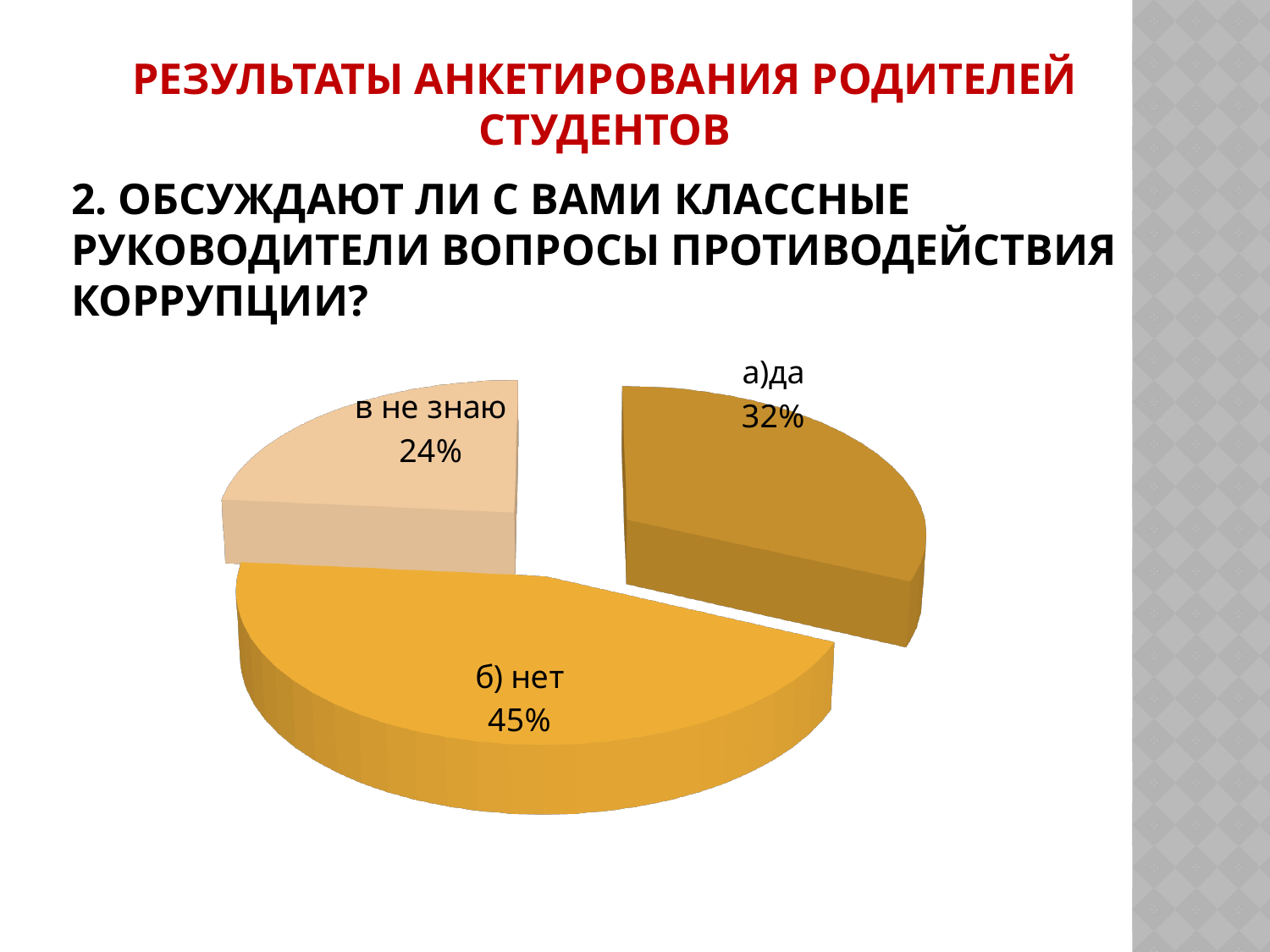
Which answer option has the smallest share of the pie? в не знаю How many slices does the pie chart have? 3 Which answer option has the largest share of the pie? б) нет What percentage of respondents answered "б) нет"? 45% What is the difference in percentage points between "б) нет" and "а)да"? 13 Which is larger, the share for "а)да" or the share for "в не знаю"? а)да What is the share of the pie for the "б) нет" slice? 45% What percentage of respondents answered "а)да"? 32% Which slice of the pie is the lightest in colour? в не знаю What kind of chart is shown on the slide? pie chart What percentage of respondents answered "в не знаю"? 24% What is the difference in percentage points between "а)да" and "в не знаю"? 8